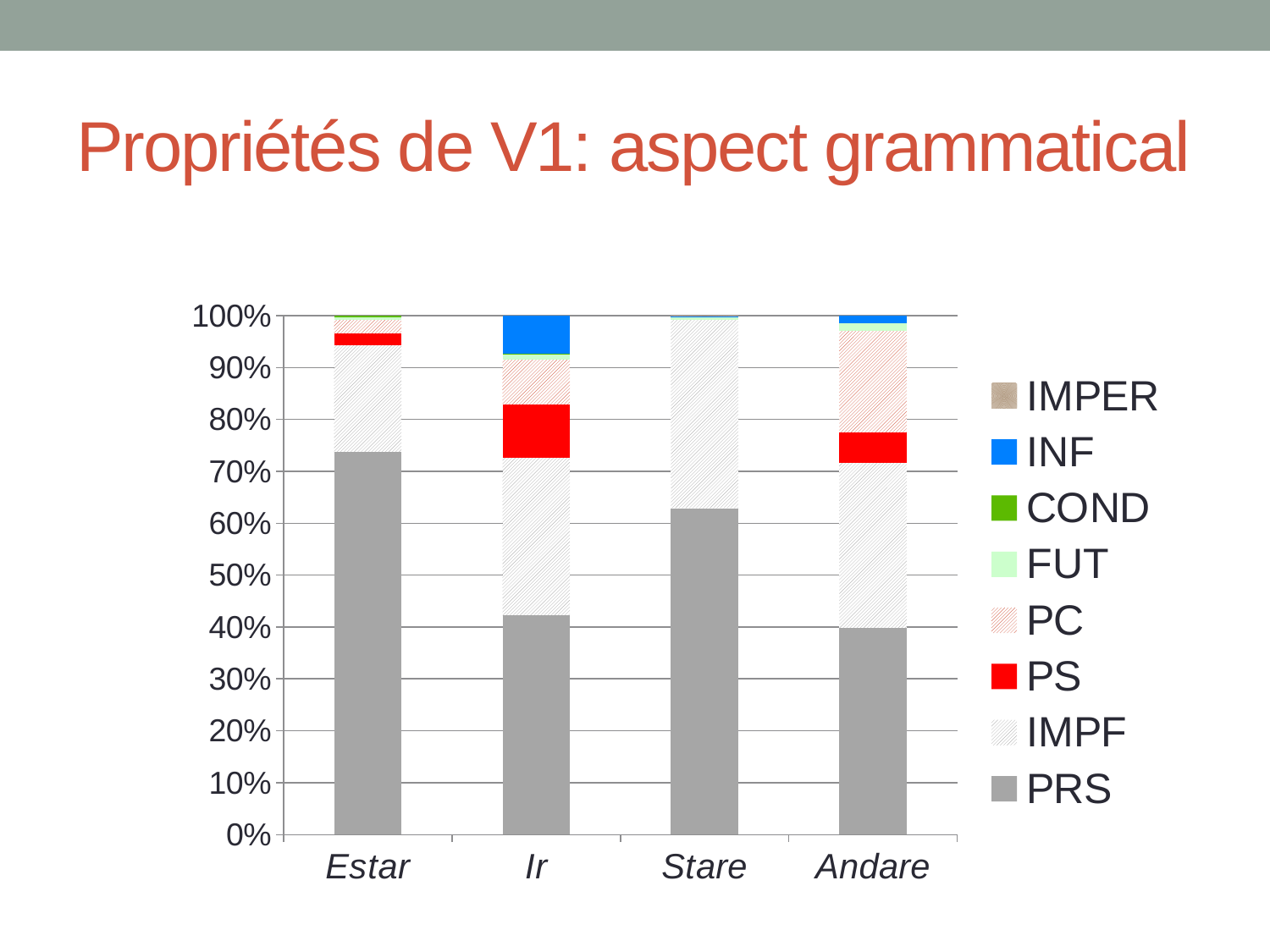
Which is larger, the PRS share for Estar or the PRS share for Ir? Estar Is the PRS value for Stare greater or less than 60%? greater How many categories are shown on the x axis of the chart? 4 How many series does the chart's legend list? 8 Is the PRS value for Estar greater or less than 70%? greater Which category has the highest PRS share? Estar What is the title of the slide containing the chart? Propriétés de V1: aspect grammatical Is the PRS value for Ir greater or less than 50%? less Which category has the largest PS segment? Ir Which series is shown at the bottom of each stacked bar? PRS What kind of chart is shown on the slide? Stacked bar chart